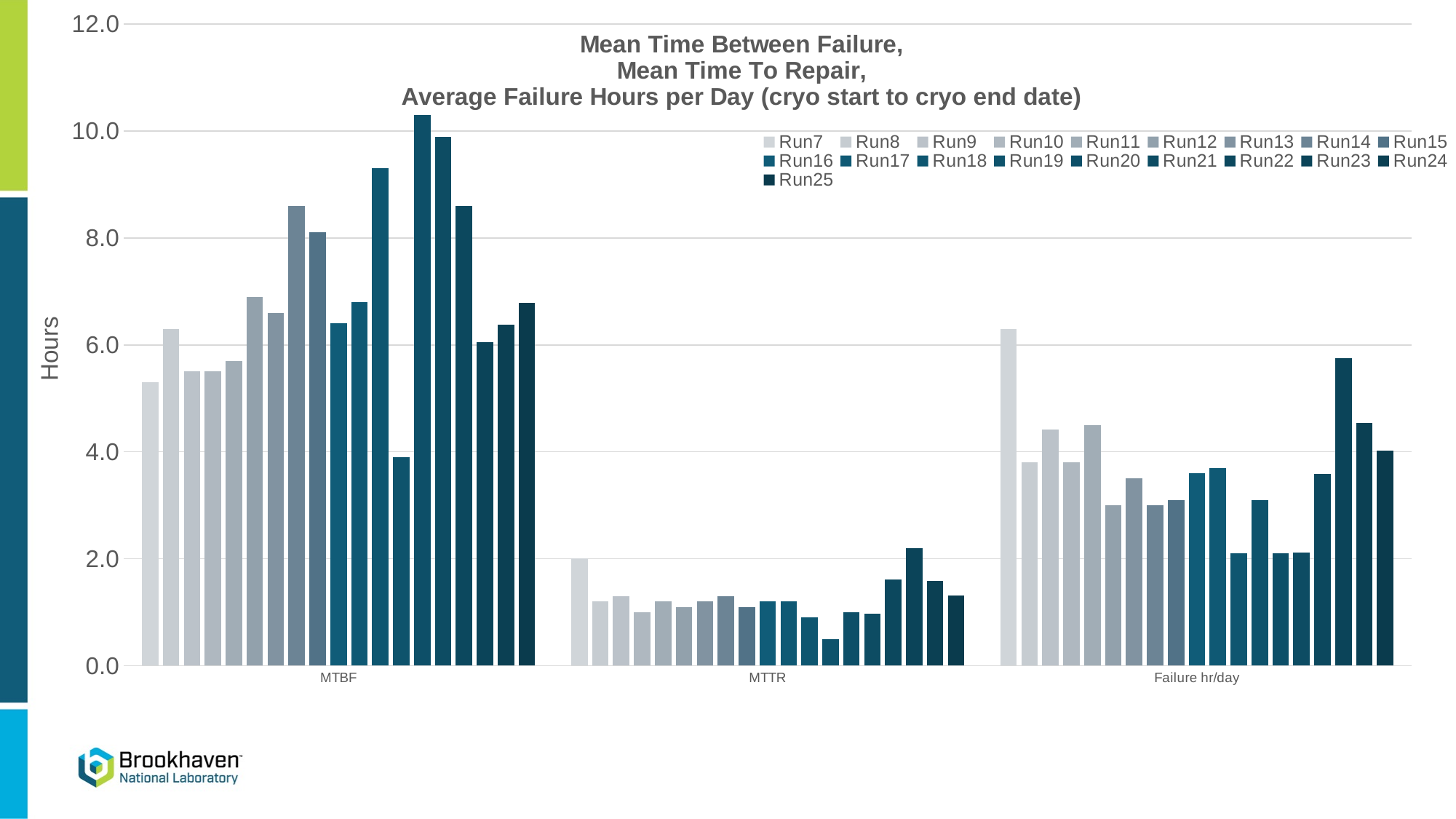
What kind of chart is shown on the slide? bar chart How many series does the chart's legend list? 19 How many categories are shown on the x axis of the chart? 3 What is the label of the y axis? Hours Is the tallest bar in the Failure hr/day group larger or smaller than the tallest bar in the MTBF group? smaller What is the first series listed in the legend? Run7 Which category contains the tallest bar in the chart? MTBF Is the leftmost (Run7) bar in the Failure hr/day group greater or less than 6.0? greater Is the tallest bar in the MTBF group greater or less than 10.0? greater Is the tallest bar in the MTTR group greater or less than 4.0? less Which category has the lowest bars overall? MTTR